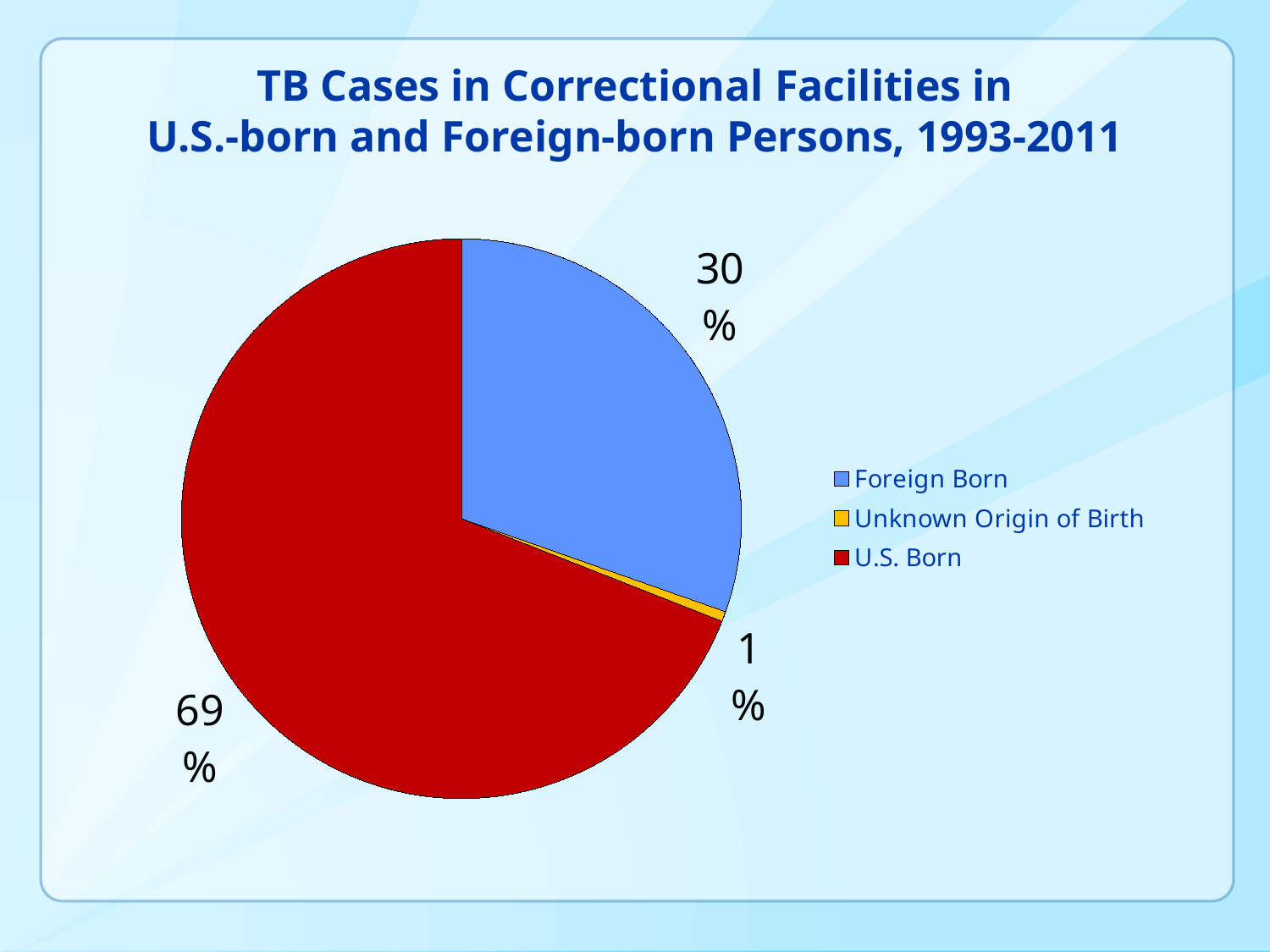
What is the difference in percentage points between the Foreign Born and Unknown Origin of Birth slices? 29 Which category has the smallest slice of the pie? Unknown Origin of Birth Which category has the largest slice of the pie? U.S. Born Which is larger, the Foreign Born slice or the U.S. Born slice? U.S. Born What share of TB cases in correctional facilities is for U.S. Born persons? 69% What share of TB cases in correctional facilities is for persons of Unknown Origin of Birth? 1% What share of TB cases in correctional facilities is for Foreign Born persons? 30% What kind of chart is shown on the slide? pie chart How many categories does the pie chart show? 3 What colour is the U.S. Born slice in the pie chart? red What is the title of the chart? TB Cases in Correctional Facilities in U.S.-born and Foreign-born Persons, 1993-2011 What is the difference in percentage points between the U.S. Born and Foreign Born slices? 39